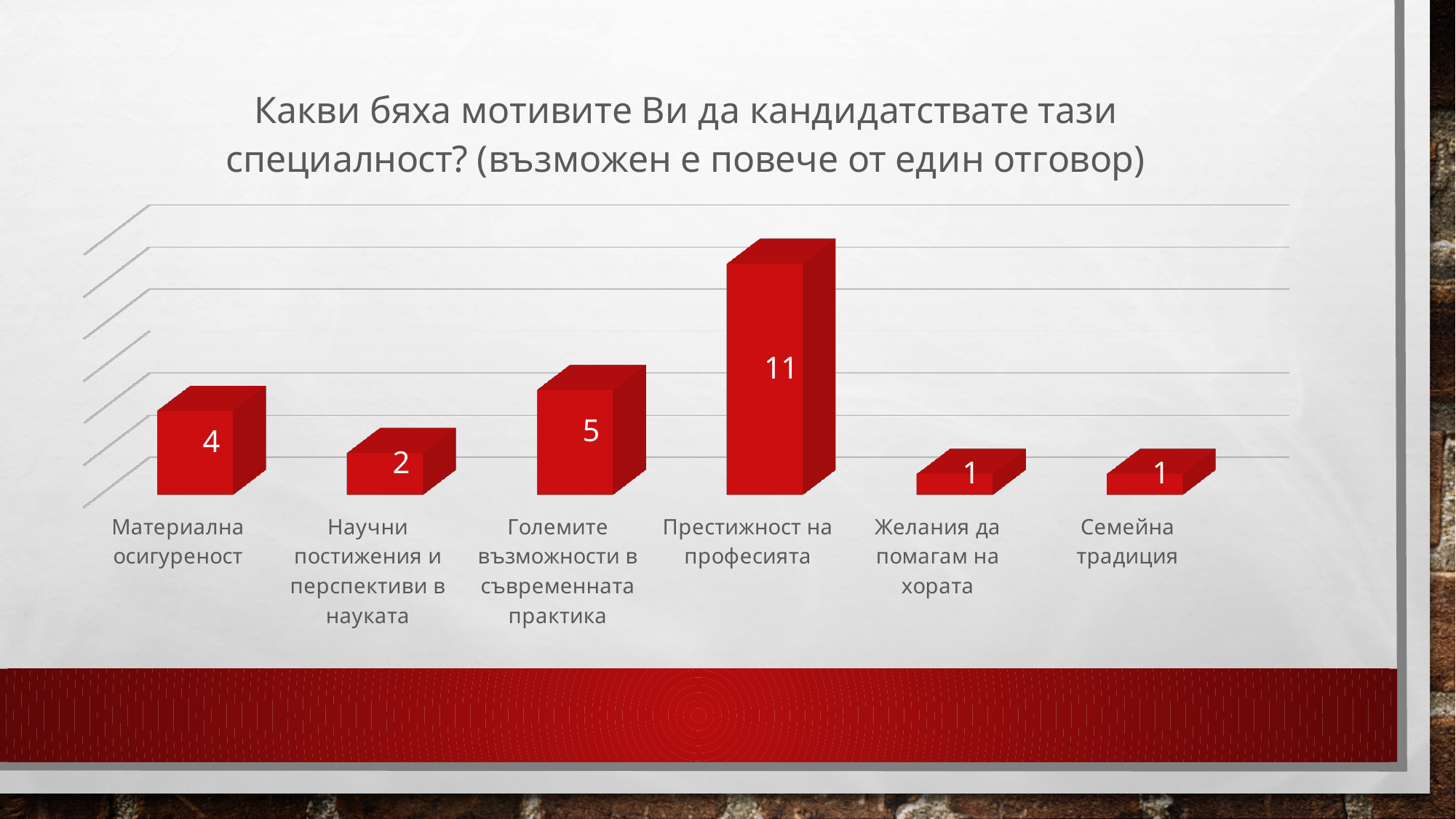
Which category has the highest value? Престижност на професията What is the value for Научни постижения и перспективи в науката? 2 What is the value for Престижност на професията? 11 What colour are the bars in the chart? Red What is the value for Големите възможности в съвременната практика? 5 How many categories are shown in the chart? 6 What is the difference between the values for Престижност на професията and Големите възможности в съвременната практика? 6 What is the difference between the values for Материална осигуреност and Научни постижения и перспективи в науката? 2 What is the value for Материална осигуреност? 4 Which is larger, the value for Материална осигуреност or the value for Големите възможности в съвременната практика? Големите възможности в съвременната практика What is the value for Семейна традиция? 1 What kind of chart is shown on the slide? Bar chart